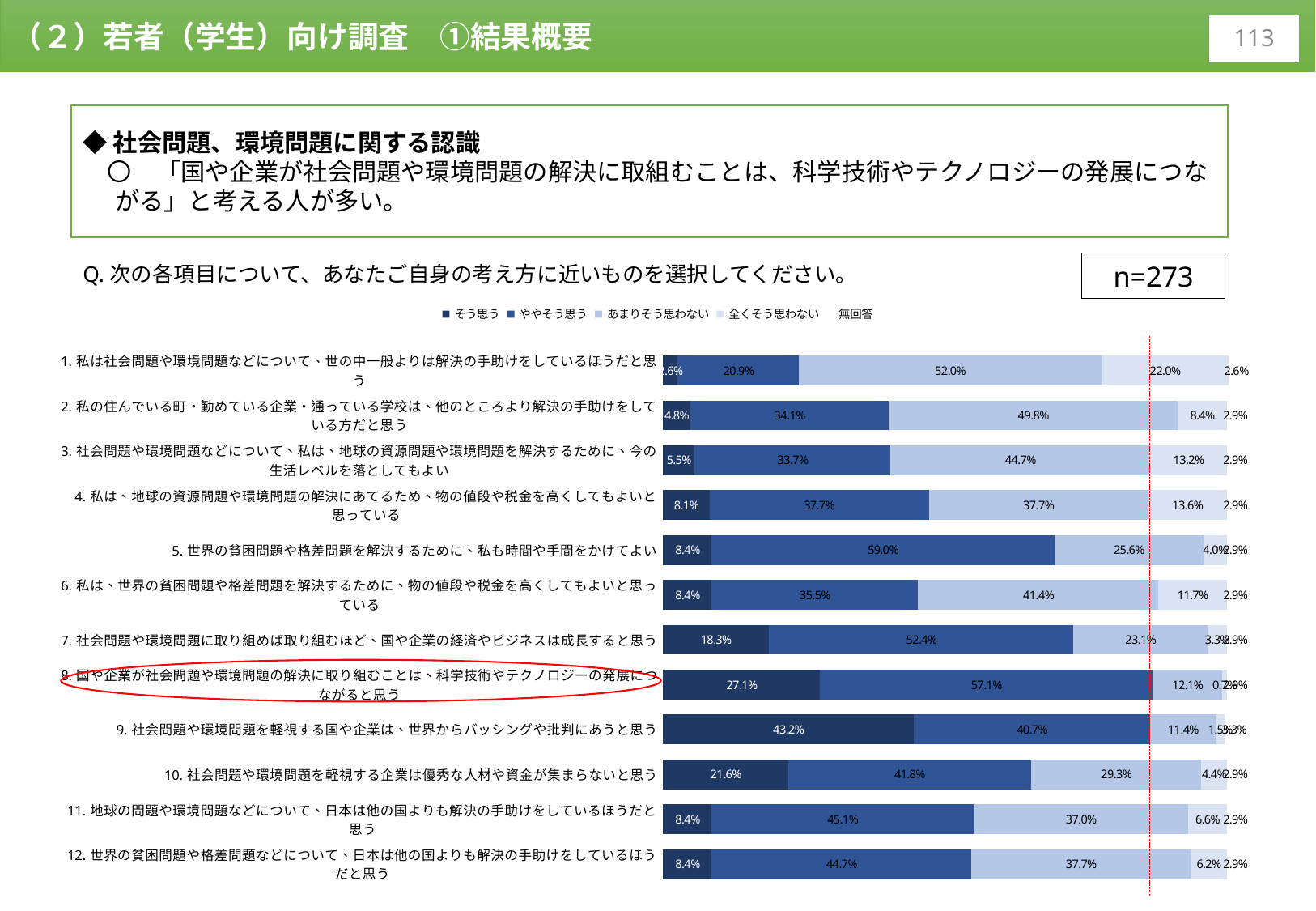
What is the 全くそう思わない value for item 4? 13.6% What is the そう思う value for item 9 (社会問題や環境問題を軽視する国や企業は、世界からバッシングや批判にあうと思う)? 43.2% For item 7, how much larger is the ややそう思う share than the そう思う share? 34.1 percentage points Which has the larger ややそう思う share: item 5 or item 10? Item 5 (59.0%) Which item has the lowest そう思う share? Item 1 (2.6%) Which item has the highest そう思う share? Item 9 (43.2%) How many survey items (categories) are plotted in the chart? 12 How many series does the legend list? 5 What is the あまりそう思わない value for item 1? 52.0% What is the ややそう思う value for item 8 (国や企業が社会問題や環境問題の解決に取り組むことは、科学技術やテクノロジーの発展につながると思う)? 57.1% What sample size (n) is shown for the survey? n=273 What kind of chart is shown on the slide? Stacked horizontal bar chart